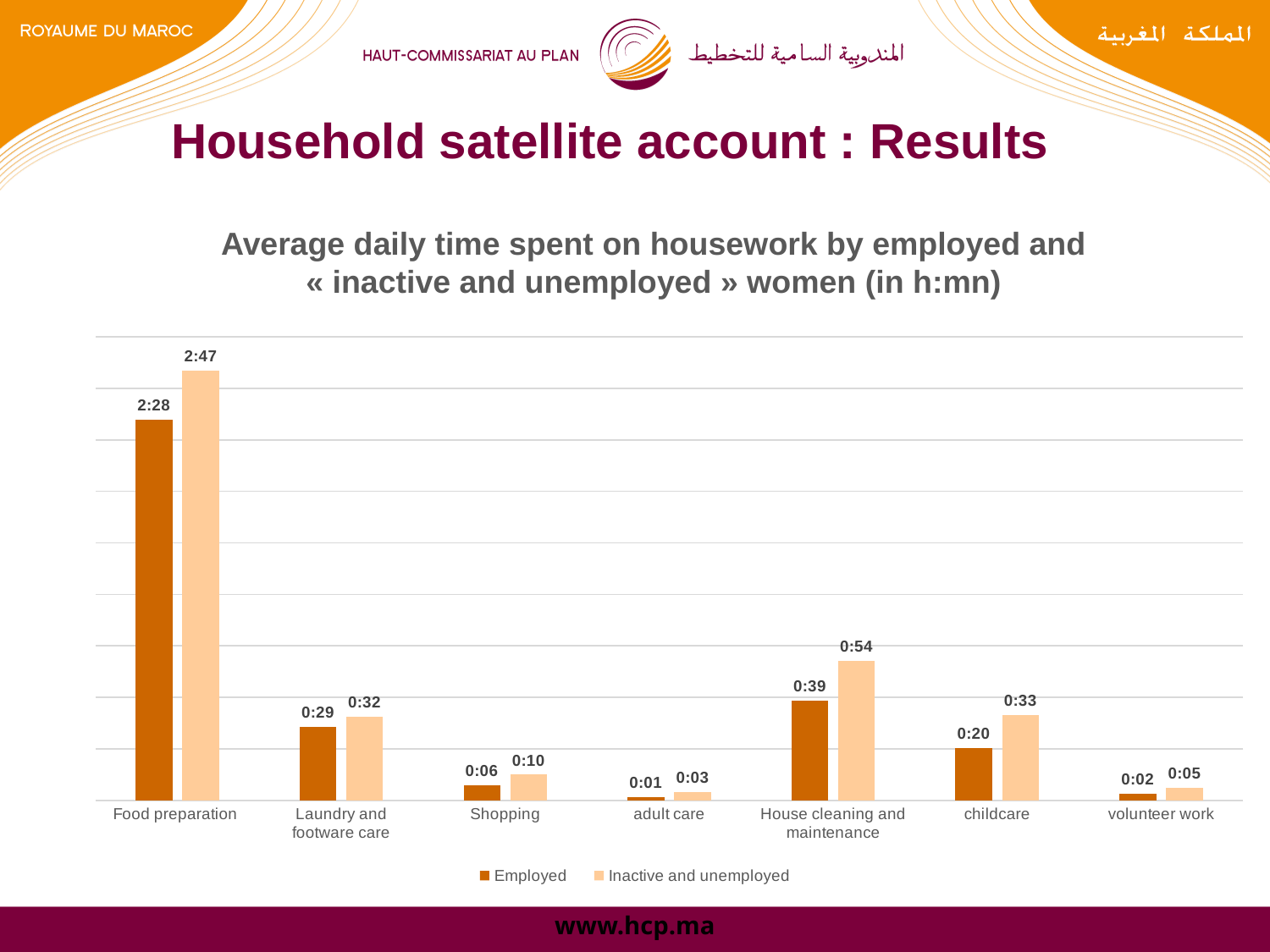
What is the value for volunteer work in the Inactive and unemployed series? 0:05 How many activity categories are shown on the x axis? 7 What is the average daily time spent on house cleaning and maintenance by inactive and unemployed women? 0:54 What is the difference between the inactive and unemployed value and the employed value for food preparation? 0:19 Which activity has the lowest value for employed women? adult care What is the average daily time spent on food preparation by employed women? 2:28 What type of chart is shown on the slide? Bar chart What is the value for childcare in the Employed series? 0:20 Which activity has the highest value for inactive and unemployed women? Food preparation How many series does the legend list? 2 For childcare, which series has the larger value, Employed or Inactive and unemployed? Inactive and unemployed What is the difference between the two series for house cleaning and maintenance? 0:15